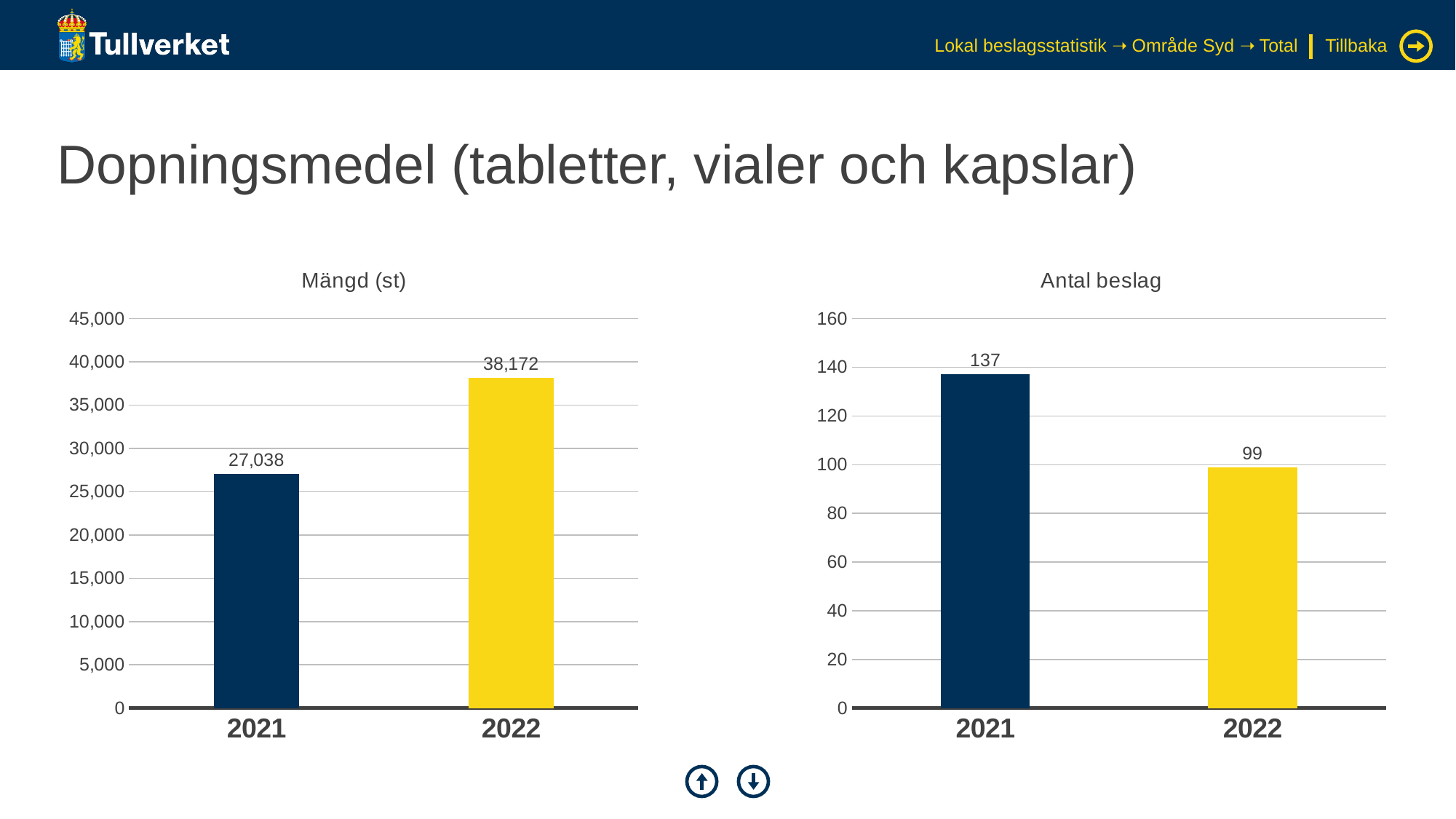
In the 'Mängd (st)' chart, which year has the higher value? 2022 In the 'Mängd (st)' chart, what is the value for 2022? 38,172 In the 'Mängd (st)' chart, do the values rise or fall from 2021 to 2022? rise In the 'Mängd (st)' chart, what is the value for 2021? 27,038 In the 'Antal beslag' chart, what is the value for 2022? 99 In the 'Antal beslag' chart, what is the difference between the 2021 and 2022 values? 38 In the 'Antal beslag' chart, how many years are shown on the x axis? 2 In the 'Antal beslag' chart, is the value for 2021 greater or less than 120? greater What kind of chart is the 'Mängd (st)' chart? bar chart In the 'Mängd (st)' chart, what is the difference between the 2022 and 2021 values? 11,134 In the 'Antal beslag' chart, what is the value for 2021? 137 In the 'Antal beslag' chart, which year has the lower value? 2022